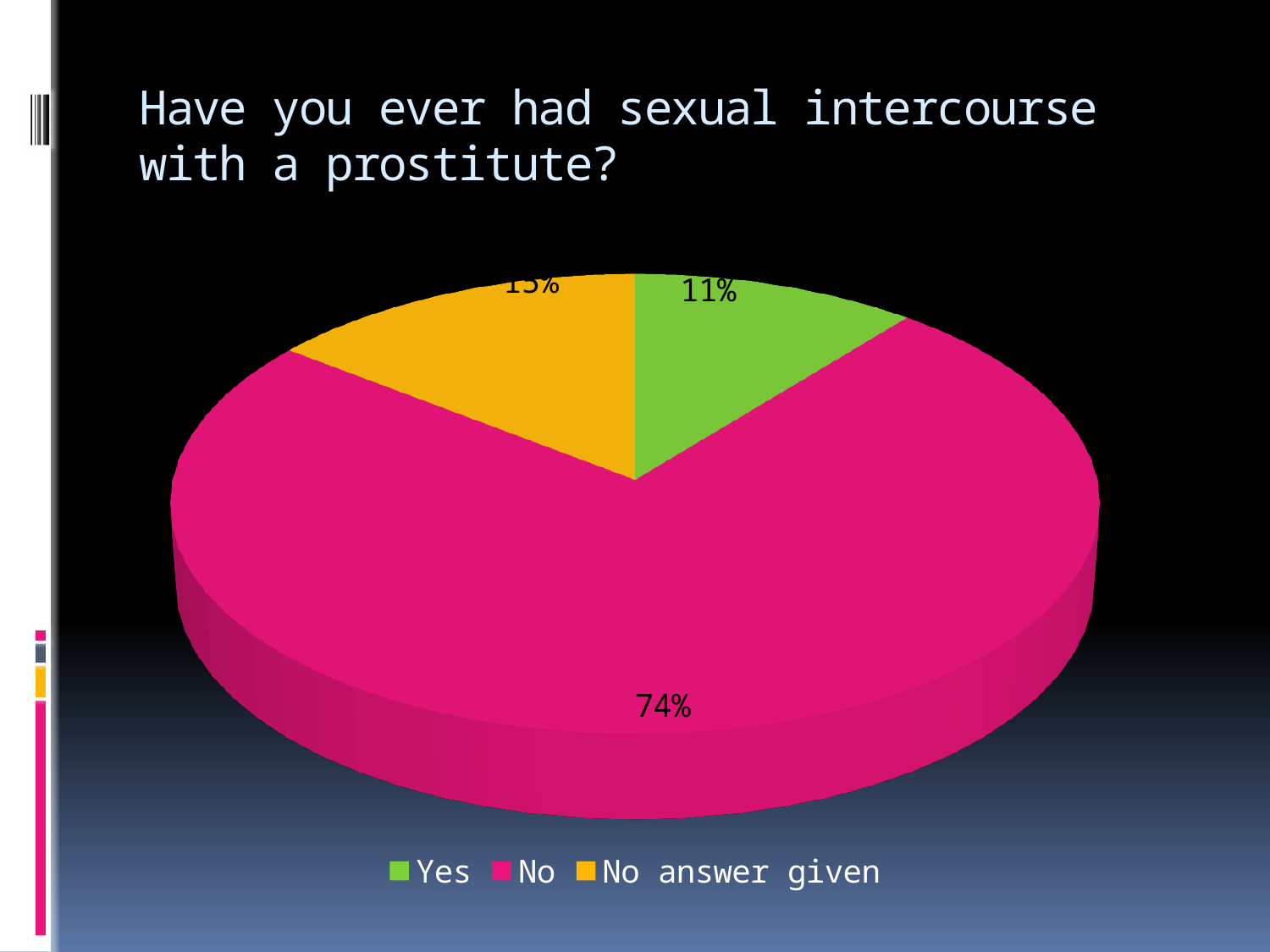
What type of chart is shown on the slide? Pie chart What percentage of respondents answered "No"? 74% Which response has the largest slice of the pie? No What share of the pie does the "No" response take? 74% Which is larger, the "Yes" slice or the "No answer given" slice? No answer given What is the difference in percentage points between the "No" and "Yes" responses? 63% What colour is the "Yes" slice? Green Which is larger, the "Yes" slice or the "No" slice? No Which response has the smallest slice of the pie? Yes What are the three entries listed in the legend? Yes, No, No answer given What percentage of respondents answered "Yes"? 11% How many response categories are shown in the pie chart? 3